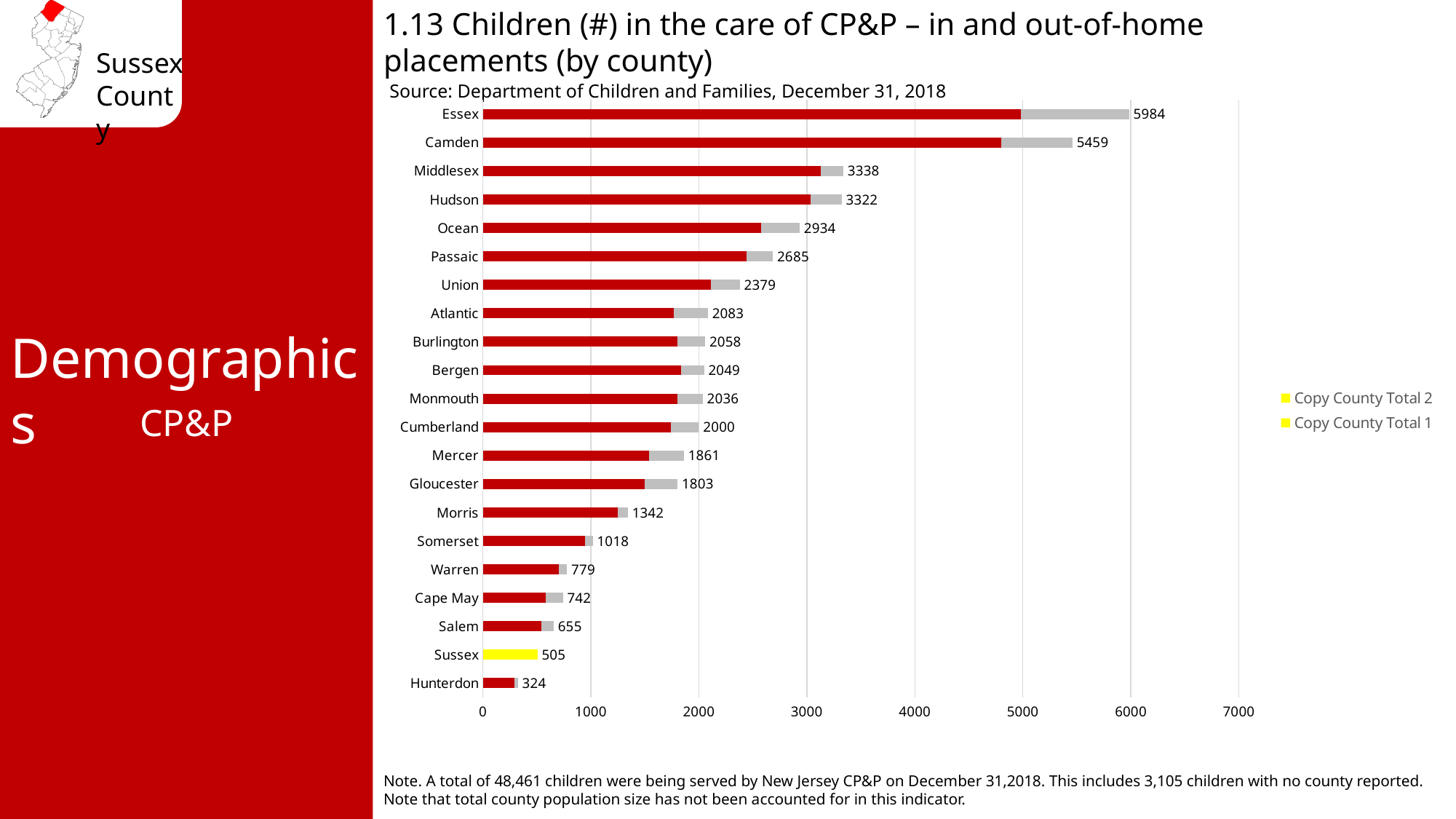
What kind of chart is shown on the slide? Bar chart Which county has the lowest total number of children in the care of CP&P? Hunterdon What is the difference between the totals for Essex and Camden? 525 What is the total value shown for Sussex county? 505 How many counties are shown on the chart? 21 What is the total number of children in the care of CP&P for Essex county? 5984 What is the total value shown for Morris county? 1342 What is the difference between the totals for Sussex and Hunterdon? 181 Which county has the highest total number of children in the care of CP&P? Essex What colour is the bar for Sussex county? Yellow Which county has a larger total, Ocean or Passaic? Ocean How many entries does the legend list? 2